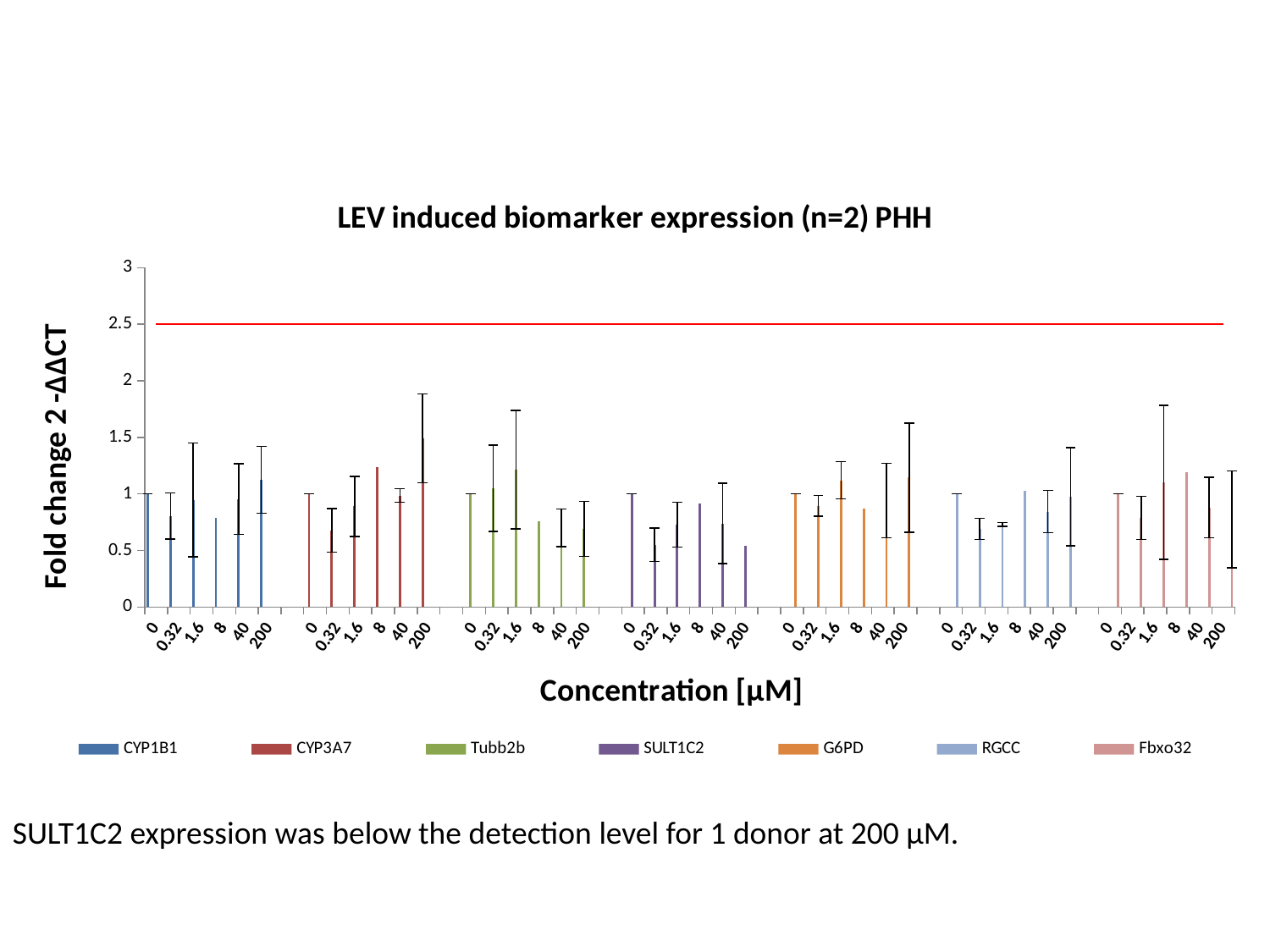
How many series does the legend list? 7 Is the value for SULT1C2 at 200 µM greater or less than 1? less At what y-axis value is the red horizontal line drawn? 2.5 At 200 µM, which is larger: the value for CYP3A7 or the value for CYP1B1? CYP3A7 Is the value for Fbxo32 at 40 µM greater or less than 1? less Is the value for CYP1B1 at 8 µM greater or less than 1? less How many concentration levels are plotted for each biomarker? 6 What is the title of the chart? LEV induced biomarker expression (n=2) PHH Which concentration gives the highest value for CYP3A7? 200 What kind of chart is shown on the slide? bar chart